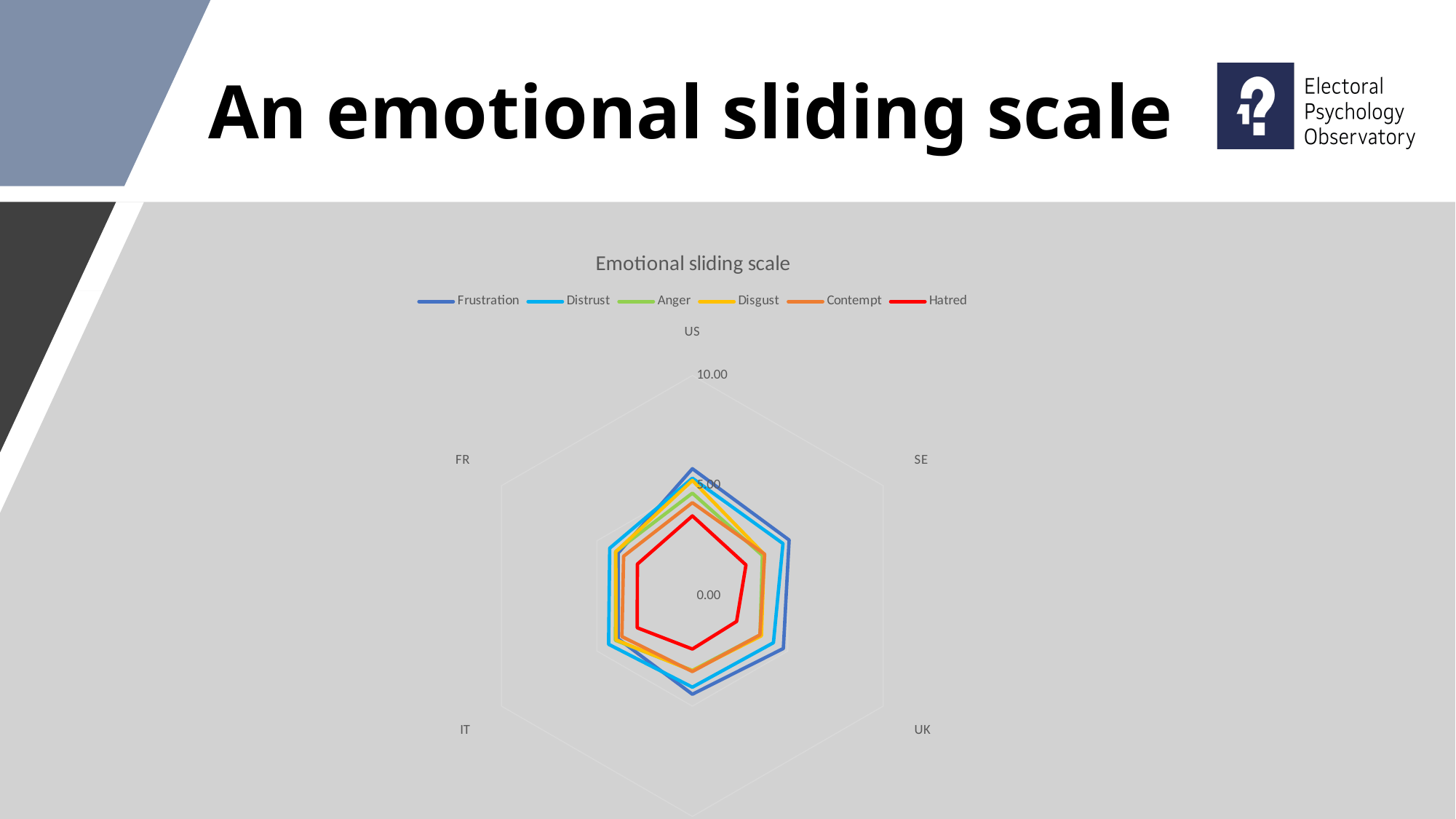
Is the value of Hatred for US greater or less than 5.00? less Which series has the lowest value for US? Hatred How many series does the legend of the chart list? 6 Is the value of Hatred for UK greater or less than 5.00? less Is the value of Frustration for US greater or less than 10.00? less For UK, which is larger: the value of Frustration or the value of Hatred? Frustration For IT, which is larger: the value of Contempt or the value of Hatred? Contempt What kind of chart is shown on the slide? Radar chart Which series has the lowest value for SE? Hatred How many category axes does the radar chart have? 6 Which colour is used for the Hatred series in the chart? Red What is the title of the chart? Emotional sliding scale